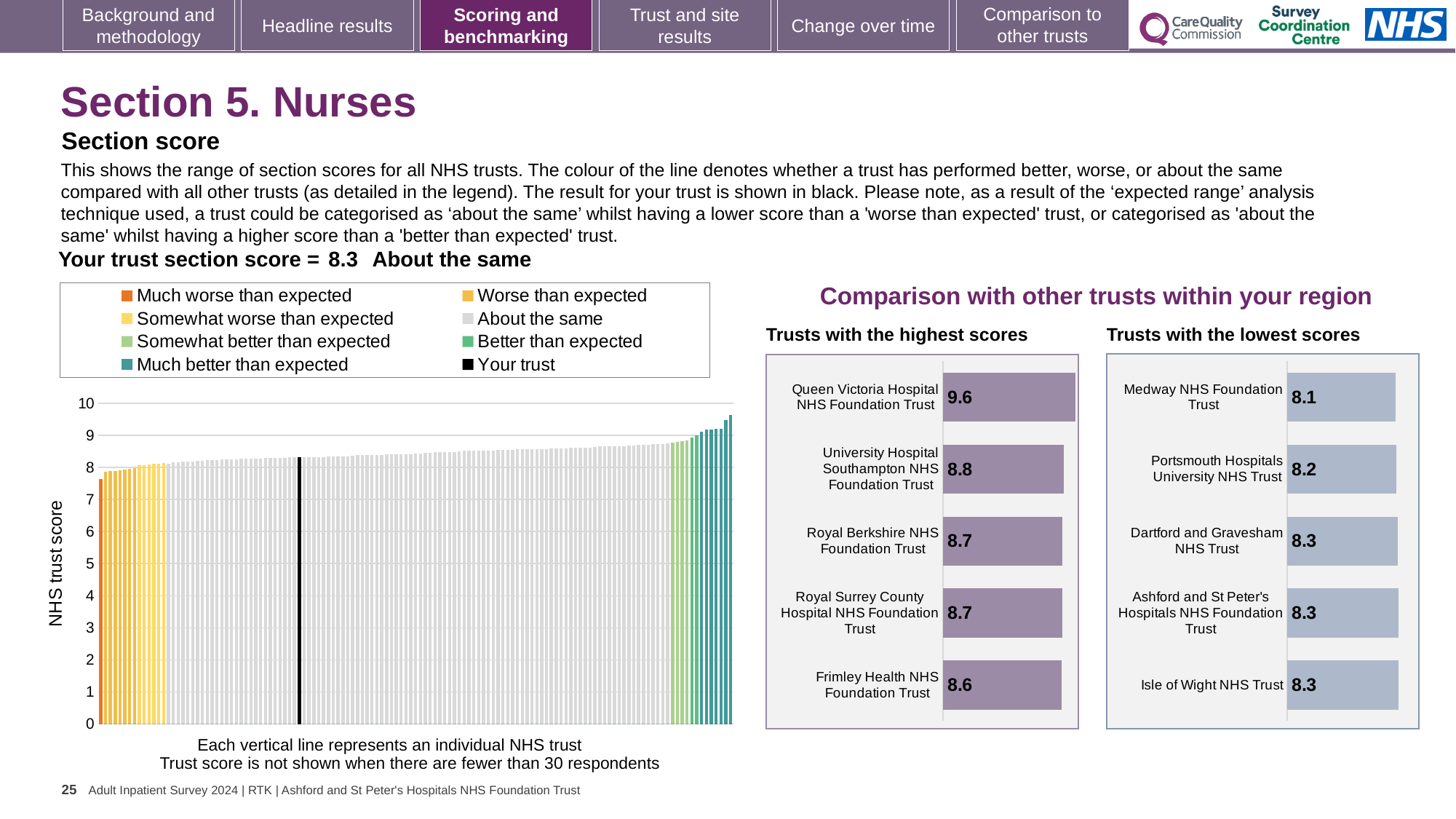
In the 'Trusts with the highest scores' chart, what is the score for Frimley Health NHS Foundation Trust? 8.6 What kind of chart is the 'Trusts with the lowest scores' chart? bar chart In the 'Trusts with the highest scores' chart, what is the difference between the scores of Queen Victoria Hospital NHS Foundation Trust and University Hospital Southampton NHS Foundation Trust? 0.8 In the main chart on the left showing all NHS trusts, is the value for your trust (the black line) greater or less than 5? greater In the 'Trusts with the lowest scores' chart, which has the larger score: Portsmouth Hospitals University NHS Trust or Medway NHS Foundation Trust? Portsmouth Hospitals University NHS Trust In the main chart on the left showing all NHS trusts, what is the section score for your trust (the black line)? 8.3 How many trusts are shown in the 'Trusts with the highest scores' chart? 5 In the 'Trusts with the lowest scores' chart, what is the score for Medway NHS Foundation Trust? 8.1 In the 'Trusts with the lowest scores' chart, which trust has the lowest score? Medway NHS Foundation Trust In the 'Trusts with the highest scores' chart, what is the score for Queen Victoria Hospital NHS Foundation Trust? 9.6 How many entries does the legend of the main chart on the left list? 8 In the 'Trusts with the highest scores' chart, which trust has the highest score? Queen Victoria Hospital NHS Foundation Trust